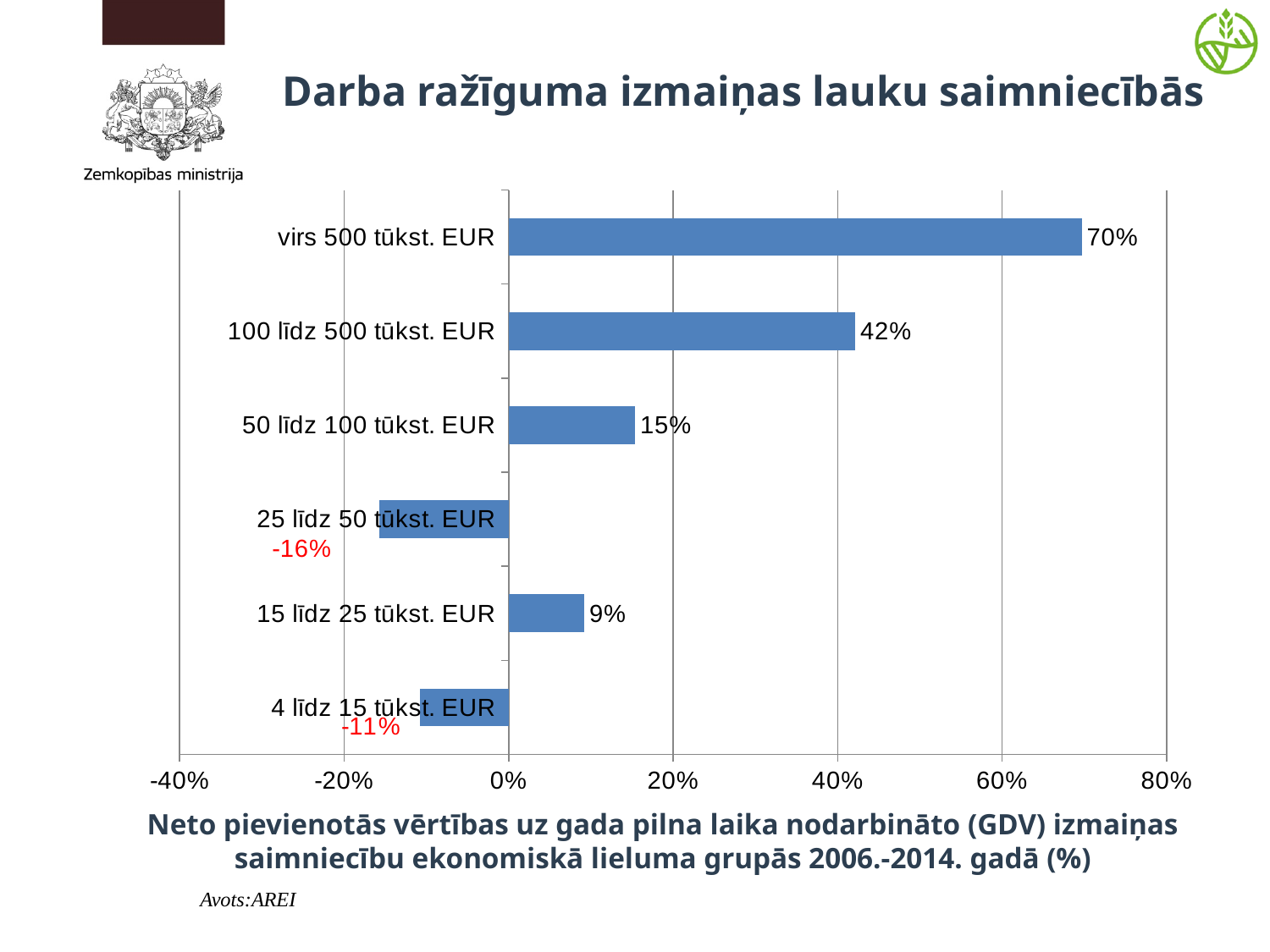
Which is larger, the value for '50 līdz 100 tūkst. EUR' or '15 līdz 25 tūkst. EUR'? 50 līdz 100 tūkst. EUR Which category has the highest value? virs 500 tūkst. EUR What is the source cited below the chart? AREI What kind of chart is shown on the slide? bar chart What is the value for 'virs 500 tūkst. EUR'? 70% Which category has the lowest value? 25 līdz 50 tūkst. EUR What is the difference between the values for 'virs 500 tūkst. EUR' and '100 līdz 500 tūkst. EUR'? 28% How many categories are shown in the chart? 6 Is the value for '100 līdz 500 tūkst. EUR' greater or less than 40%? greater What is the value for '25 līdz 50 tūkst. EUR'? -16% What is the value for '100 līdz 500 tūkst. EUR'? 42% What is the value for '4 līdz 15 tūkst. EUR'? -11%